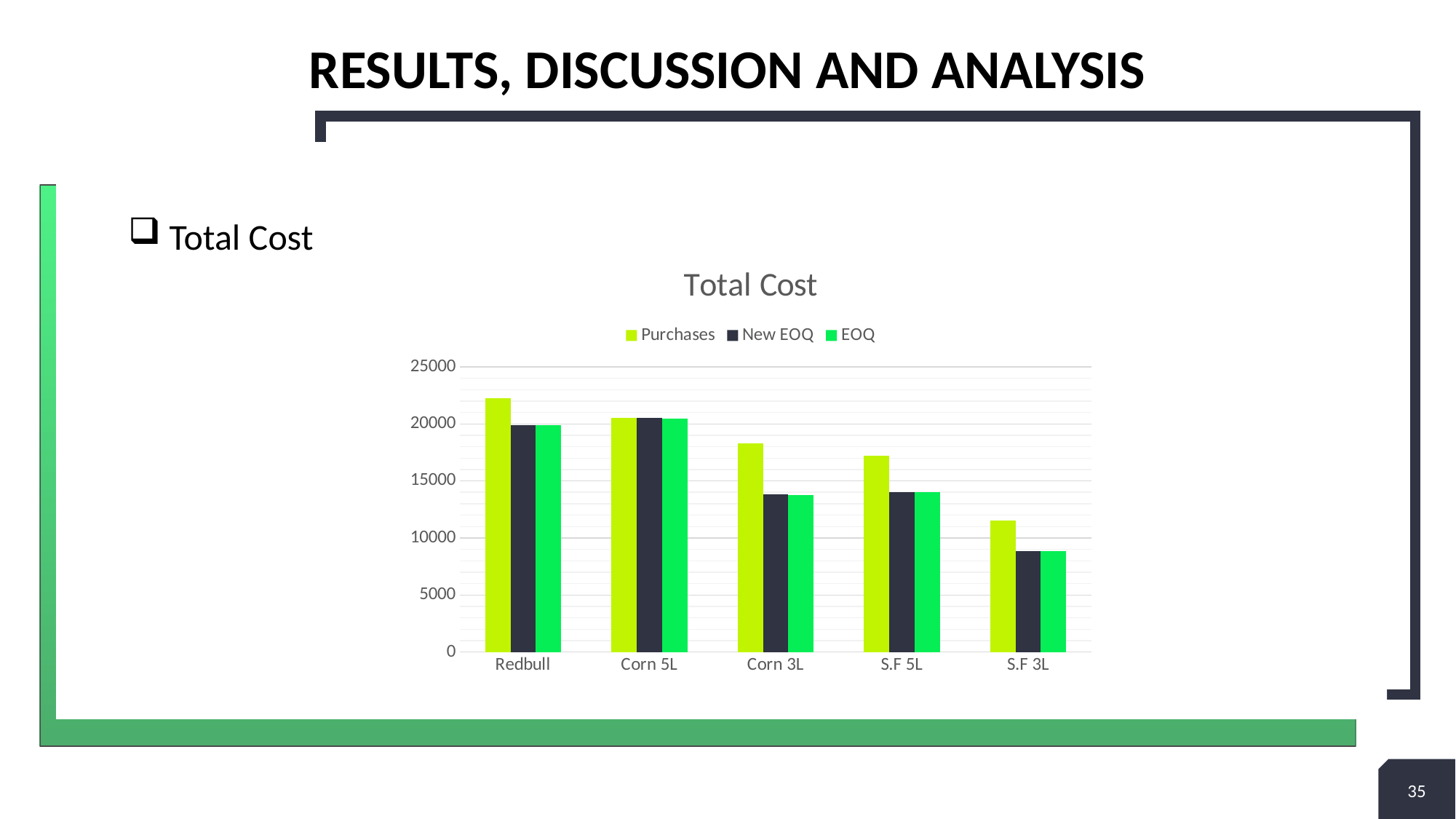
How many categories are shown on the x axis? 5 What is the title of the chart? Total Cost Which series are listed in the legend? Purchases, New EOQ, EOQ Which is larger, the Purchases value for Corn 3L or the New EOQ value for Corn 3L? Purchases What kind of chart is shown on the slide? bar chart Which category has the lowest New EOQ value? S.F 3L Which category has the lowest Purchases value? S.F 3L Is the Purchases value for Redbull greater or less than 20000? greater How many series does the legend list? 3 Is the EOQ value for S.F 3L greater or less than 10000? less Do the Purchases values rise or fall from Redbull to S.F 3L along the x axis? fall Which category has the highest Purchases value? Redbull